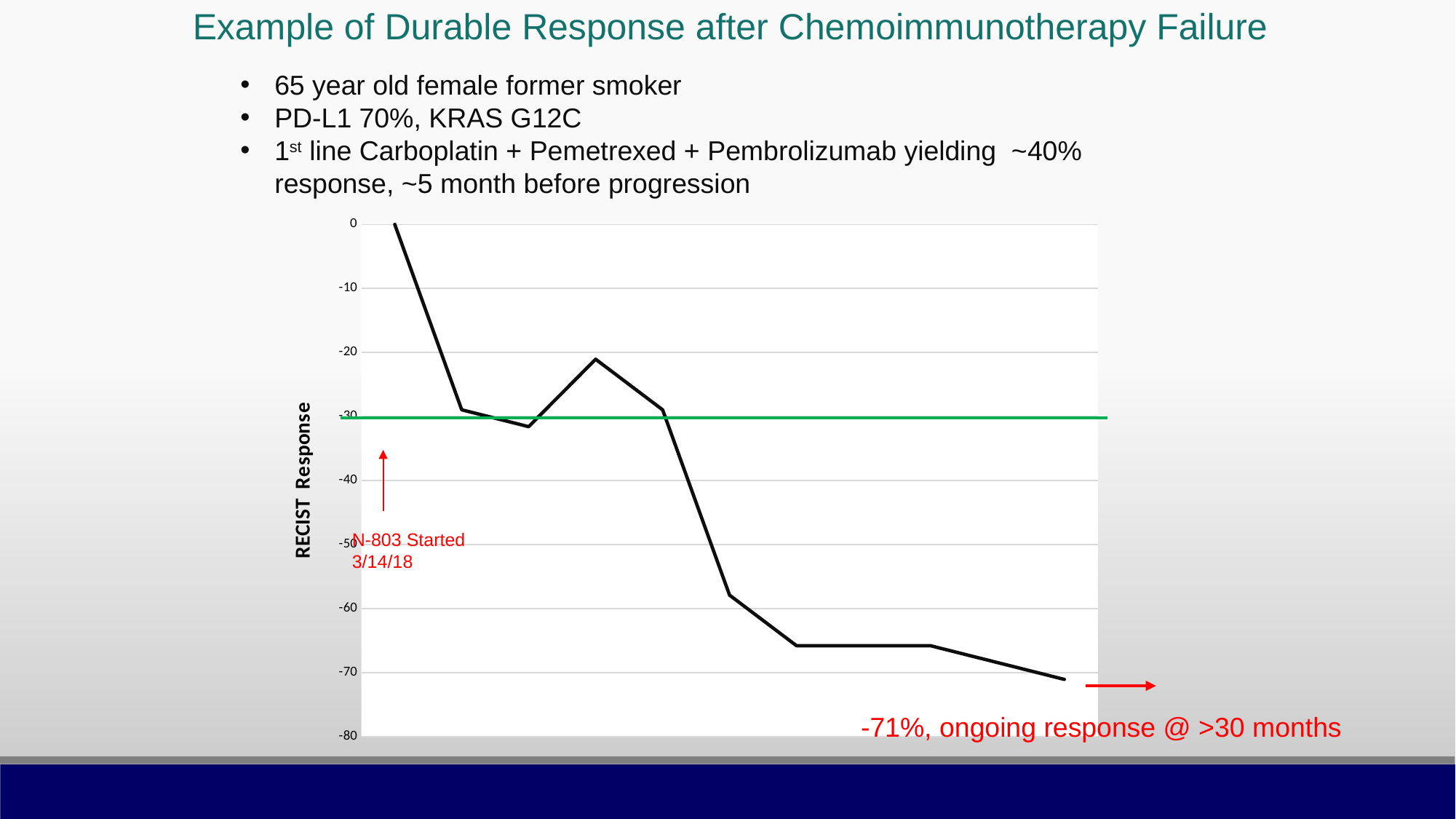
What is the value of the final point on the line, as annotated on the slide? -71% Is the lowest point on the line greater or less than -60? less According to the annotation, on what date was N-803 started? 3/14/18 Overall, do the values rise or fall along the x axis? fall Is the local peak in the middle of the line (after the initial drop) greater or less than -30? greater What is the label of the vertical axis of the chart? RECIST Response Which point on the line has the highest value, the first or the last? the first What is the lowest value shown on the vertical axis? -80 Is the second point on the line greater or less than -20? less What kind of chart is shown on the slide? line chart What is the value of the first point on the line? 0